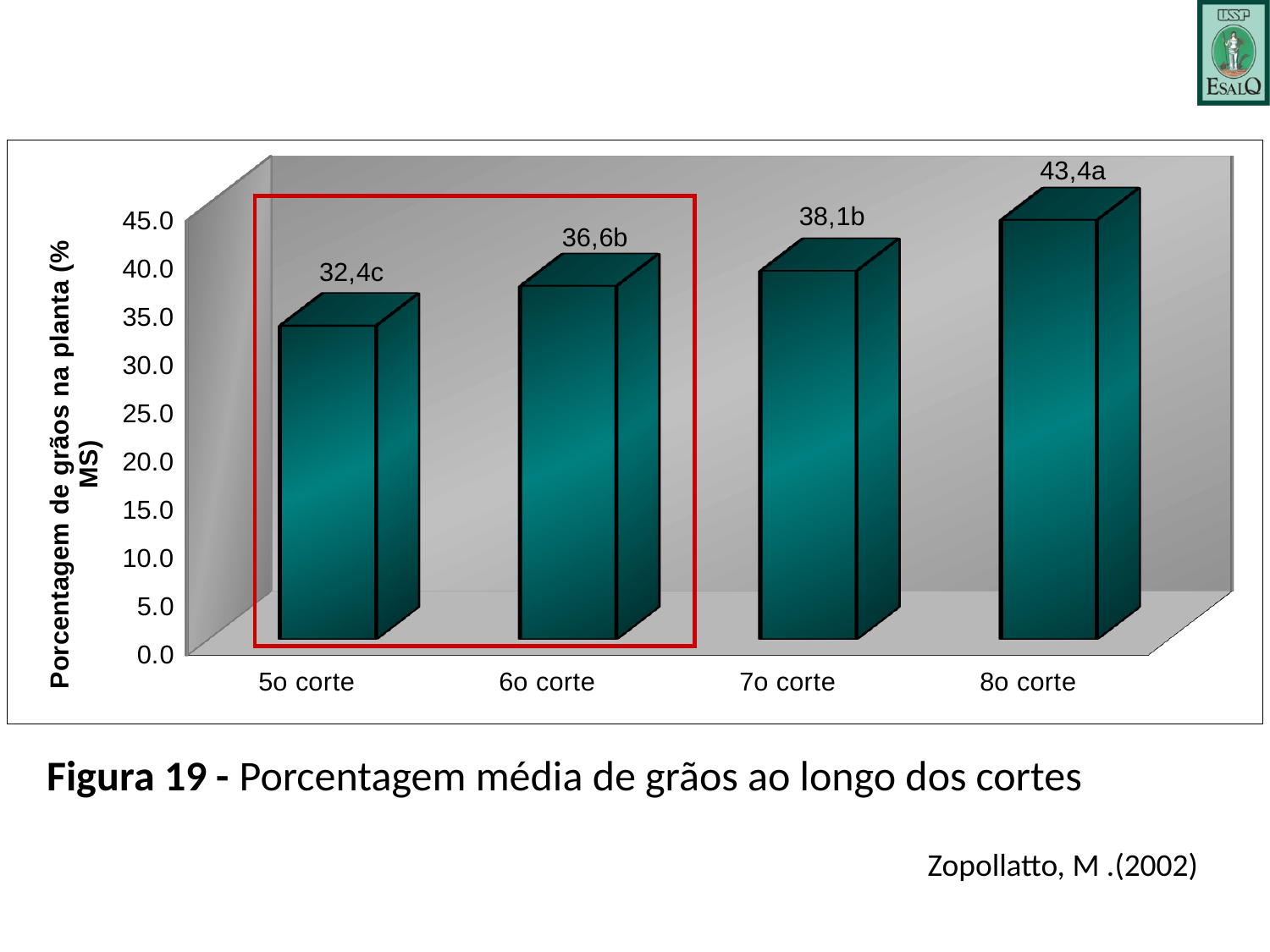
Which corte has the highest percentage of grains? 8o corte Do the values rise or fall from 5o corte to 8o corte? rise How many cortes (categories) are shown on the x axis? 4 What is the data label shown for 8o corte? 43,4a What kind of chart is shown on the slide? bar chart What is the data label shown for 7o corte? 38,1b Is the value for 8o corte greater or less than 40.0? greater What is the data label shown for 5o corte? 32,4c What is the difference between the values for 8o corte and 5o corte? 11,0 What is the difference between the values for 6o corte and 5o corte? 4,2 Which corte has the lowest percentage of grains? 5o corte Which is larger, the value for 6o corte or the value for 7o corte? 7o corte